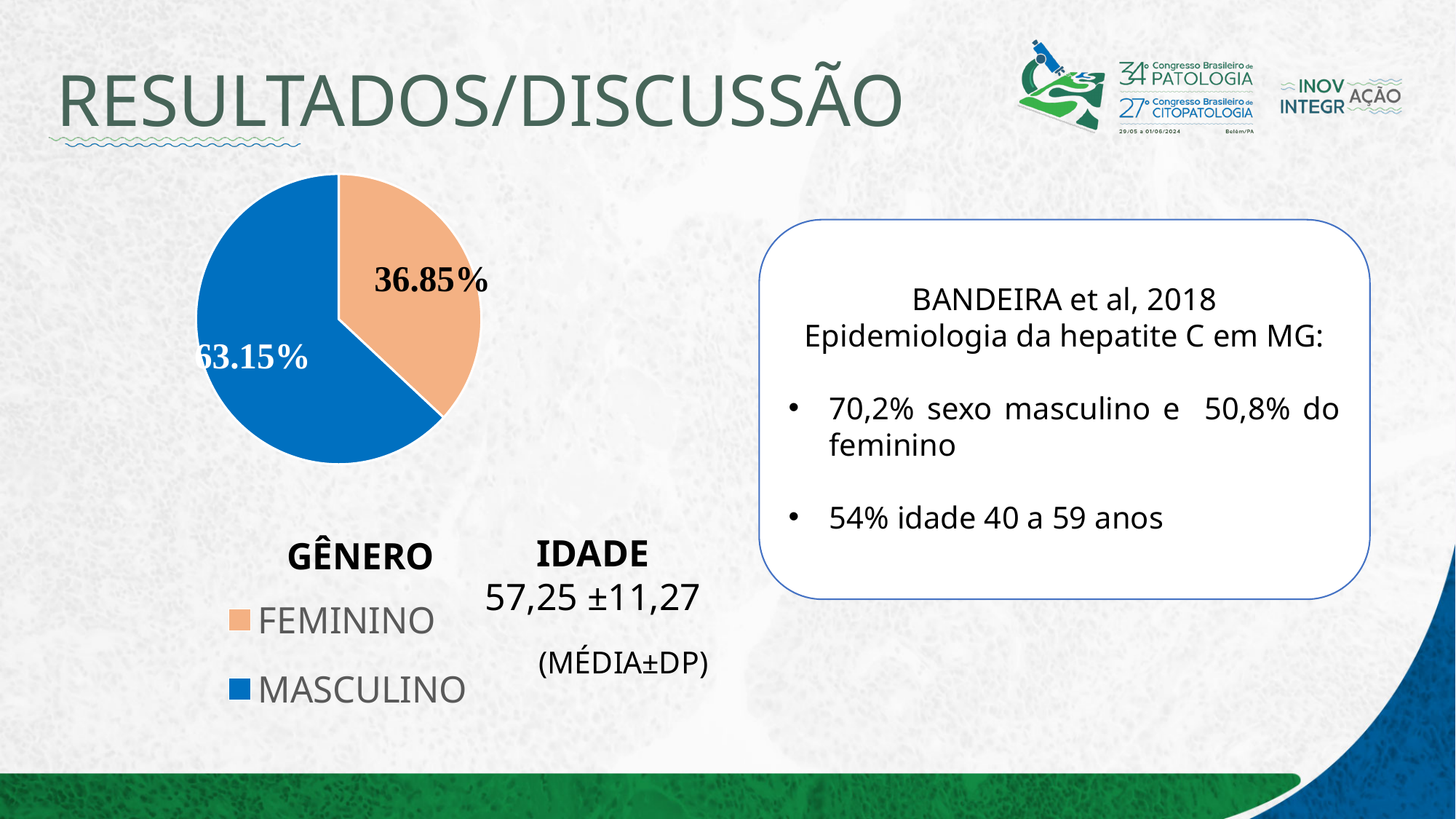
What percentage of the pie chart is FEMININO? 36.85% Which slice is larger, FEMININO or MASCULINO? MASCULINO What percentage of the pie chart is MASCULINO? 63.15% How many slices does the pie chart have? 2 What kind of chart is shown on the slide? pie chart What is the title of the pie chart's legend? GÊNERO What colour is the MASCULINO slice? blue How many entries does the legend list? 2 Is the share for FEMININO greater or less than 50%? less Which category has the smallest share of the pie chart? FEMININO Which category has the largest share of the pie chart? MASCULINO What is the difference in percentage points between the MASCULINO and FEMININO slices? 26.30%